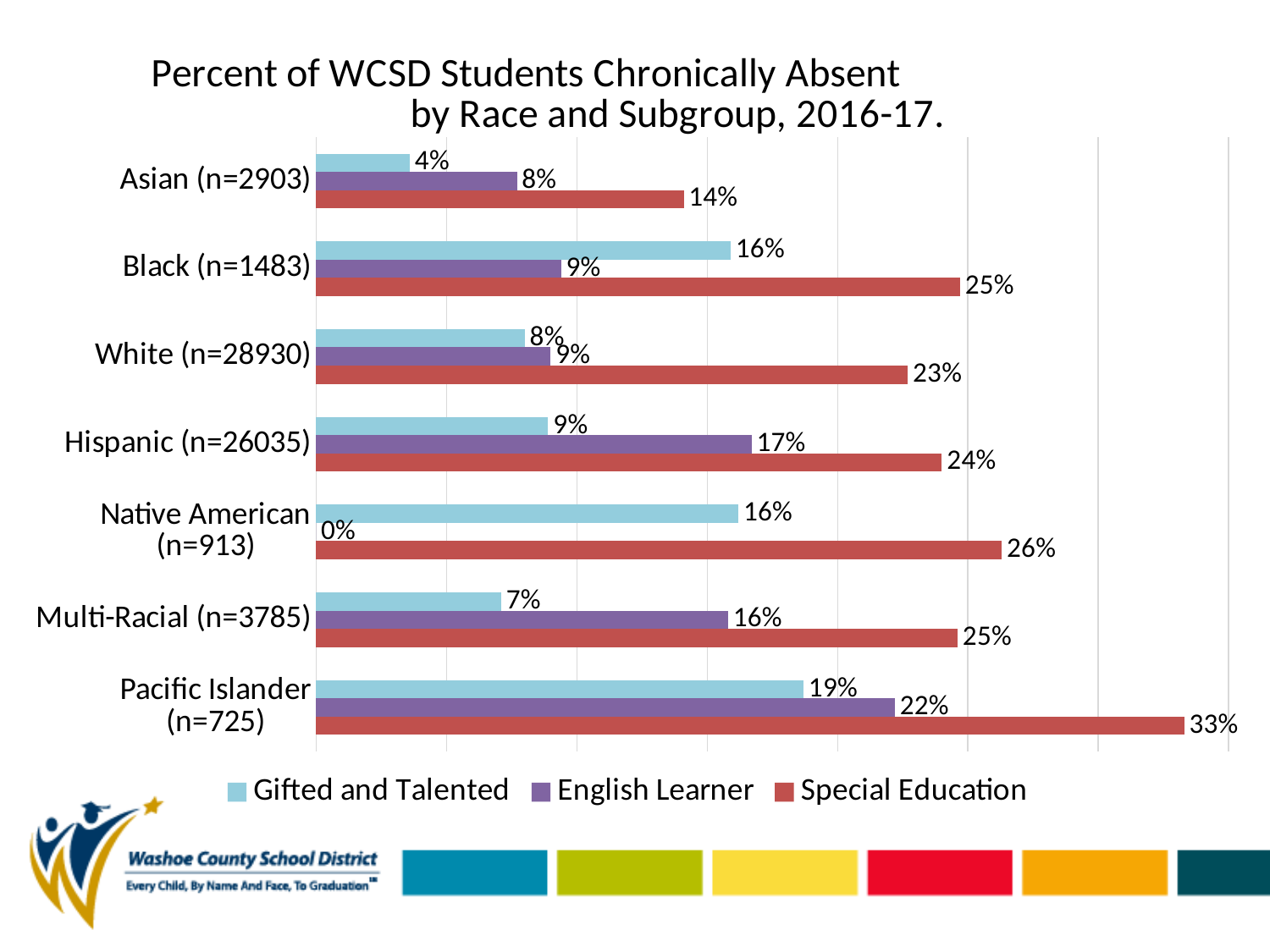
Which race category has the highest Special Education value? Pacific Islander (n=725) What is the Special Education value for Pacific Islander (n=725)? 33% How many race categories are shown on the chart? 7 Which race category has the lowest Gifted and Talented value? Asian (n=2903) How many series does the legend list? 3 What is the Gifted and Talented value for Asian (n=2903)? 4% Which is larger for Multi-Racial (n=3785): the English Learner value or the Gifted and Talented value? English Learner What is the difference between the Special Education and Gifted and Talented values for Black (n=1483)? 9% What is the English Learner value for Native American (n=913)? 0% What kind of chart is shown on the slide? Bar chart What is the English Learner value for Hispanic (n=26035)? 17% What is the title of the chart? Percent of WCSD Students Chronically Absent by Race and Subgroup, 2016-17.